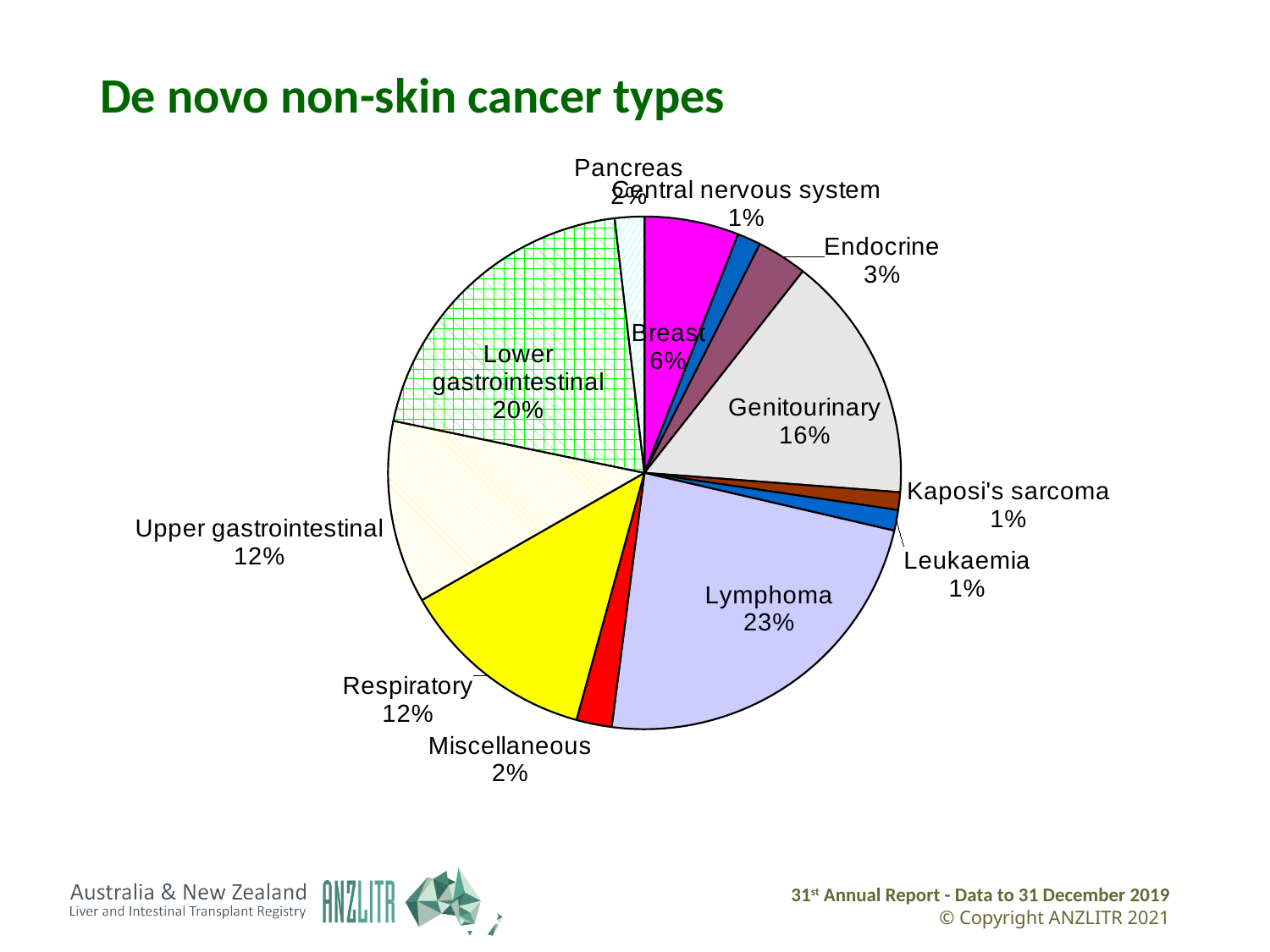
Which cancer type has the largest share of the pie? Lymphoma What percentage of the pie is Lymphoma? 23% What is the title of the chart? De novo non-skin cancer types What colour is the Respiratory slice? yellow Which is larger, the share for Genitourinary or the share for Respiratory? Genitourinary How many slices does the pie chart have? 12 What percentage of the pie is Endocrine? 3% What kind of chart is shown on the slide? pie chart What percentage of the pie is Breast? 6% What is the difference in percentage points between Lymphoma and Lower gastrointestinal? 3 What percentage of the pie is Lower gastrointestinal? 20% What percentage of the pie is Genitourinary? 16%